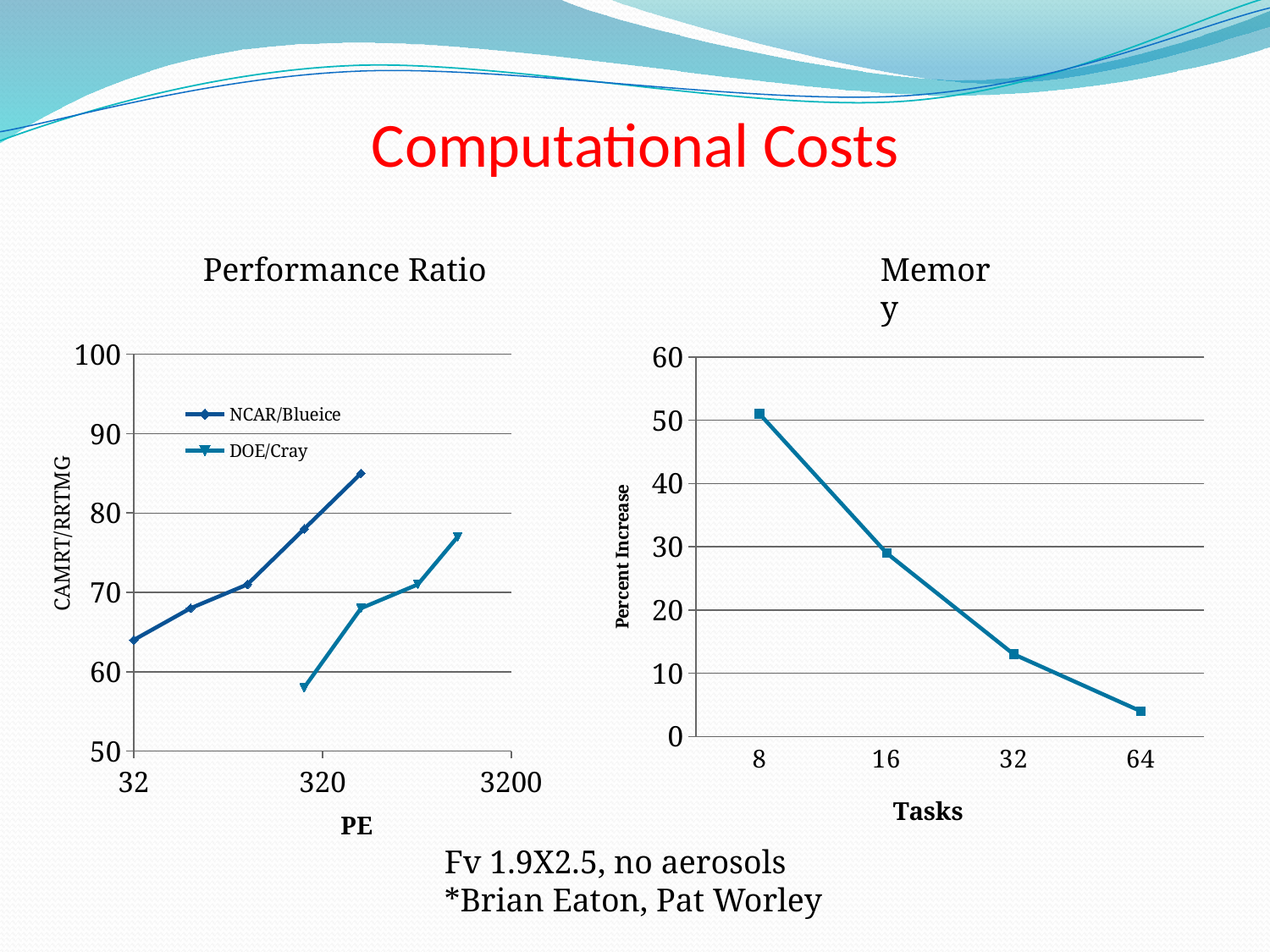
In the Performance Ratio chart, how many data points does the NCAR/Blueice series have? 5 In the Memory chart, is the percent increase at 64 tasks greater or less than 10? less In the Memory chart, does the percent increase rise or fall as the number of tasks increases? fall In the Performance Ratio chart, do the NCAR/Blueice values rise or fall as PE increases? rise How many series does the legend of the Performance Ratio chart list? 2 In the Performance Ratio chart, what are the two series named in the legend? NCAR/Blueice and DOE/Cray In the Memory chart, is the percent increase at 16 tasks greater or less than 20? greater In the Memory chart, how many task counts are plotted on the x axis? 4 In the Performance Ratio chart, is the first (lowest-PE) DOE/Cray value greater or less than 60? less In the Memory chart, which number of tasks has the highest percent increase? 8 What kind of chart is the Performance Ratio chart? line chart